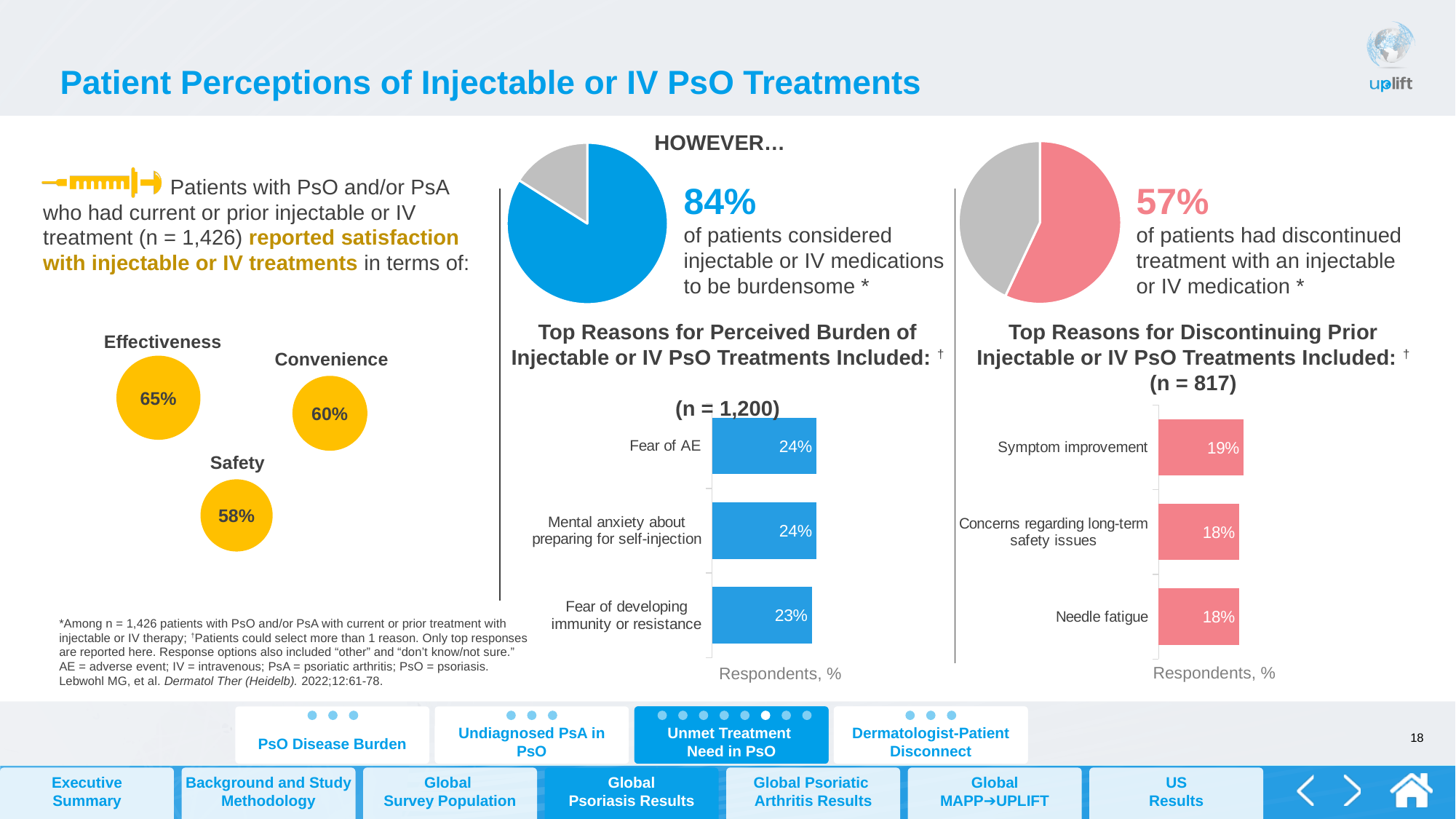
In the 'Top Reasons for Discontinuing Prior Injectable or IV PsO Treatments' bar chart, what percentage of respondents cited Needle fatigue? 18% In the pie chart on the right, what share of patients had discontinued treatment with an injectable or IV medication? 57% In the satisfaction bubble chart on the left, which category has the lowest percentage: Effectiveness, Convenience or Safety? Safety In the 'Top Reasons for Discontinuing Prior Injectable or IV PsO Treatments' bar chart, what percentage of respondents cited Symptom improvement? 19% How many reasons are shown in the 'Top Reasons for Perceived Burden of Injectable or IV PsO Treatments' bar chart? 3 In the 'Top Reasons for Perceived Burden of Injectable or IV PsO Treatments' bar chart, what percentage of respondents cited Fear of developing immunity or resistance? 23% In the 'Top Reasons for Perceived Burden of Injectable or IV PsO Treatments' bar chart, which reason has the lowest percentage? Fear of developing immunity or resistance In the 'Top Reasons for Discontinuing Prior Injectable or IV PsO Treatments' bar chart, which reason has the highest percentage? Symptom improvement What kind of chart is used to show the top reasons for discontinuing prior injectable or IV PsO treatments? Bar chart In the 'Top Reasons for Discontinuing Prior Injectable or IV PsO Treatments' bar chart, what is the difference between Symptom improvement and Needle fatigue? 1% In the 'Top Reasons for Perceived Burden of Injectable or IV PsO Treatments' bar chart, what percentage of respondents cited Fear of AE? 24% In the satisfaction bubble chart on the left, what percentage of patients reported satisfaction in terms of Effectiveness? 65%